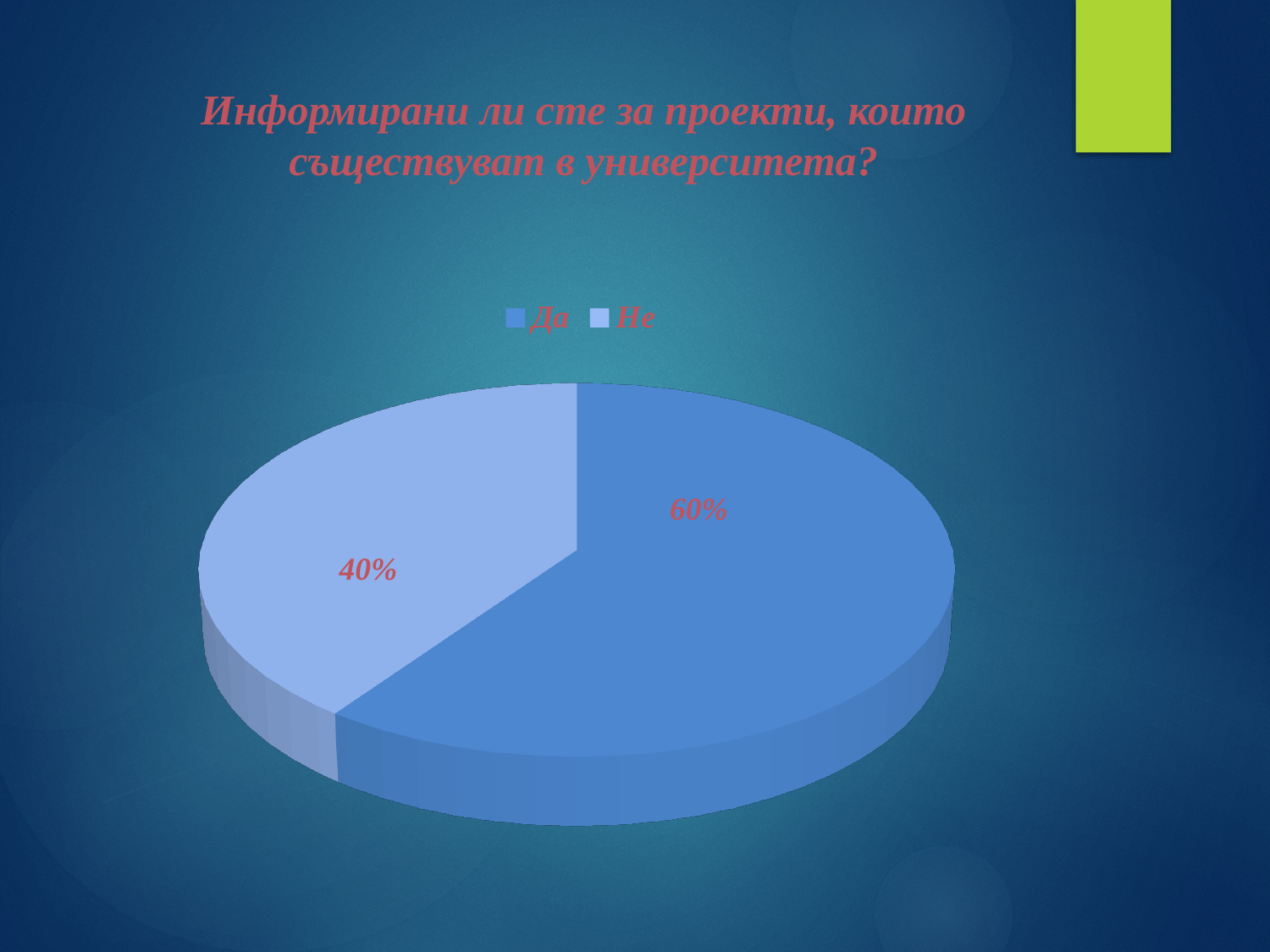
How many categories are shown in the pie chart? 2 What share of the pie does the "Да" slice represent? 60% What is the difference in percentage points between the "Да" and "Не" slices? 20% Which legend entry is shown in the lighter blue colour? Не What share of the pie does the "Не" slice represent? 40% What kind of chart is shown on the slide? Pie chart Which category has the smallest slice of the pie? Не Which is larger, the "Да" slice or the "Не" slice? Да How many entries does the legend list? 2 Which category has the largest slice of the pie? Да What is the title of the chart on the slide? Информирани ли сте за проекти, които съществуват в университета?